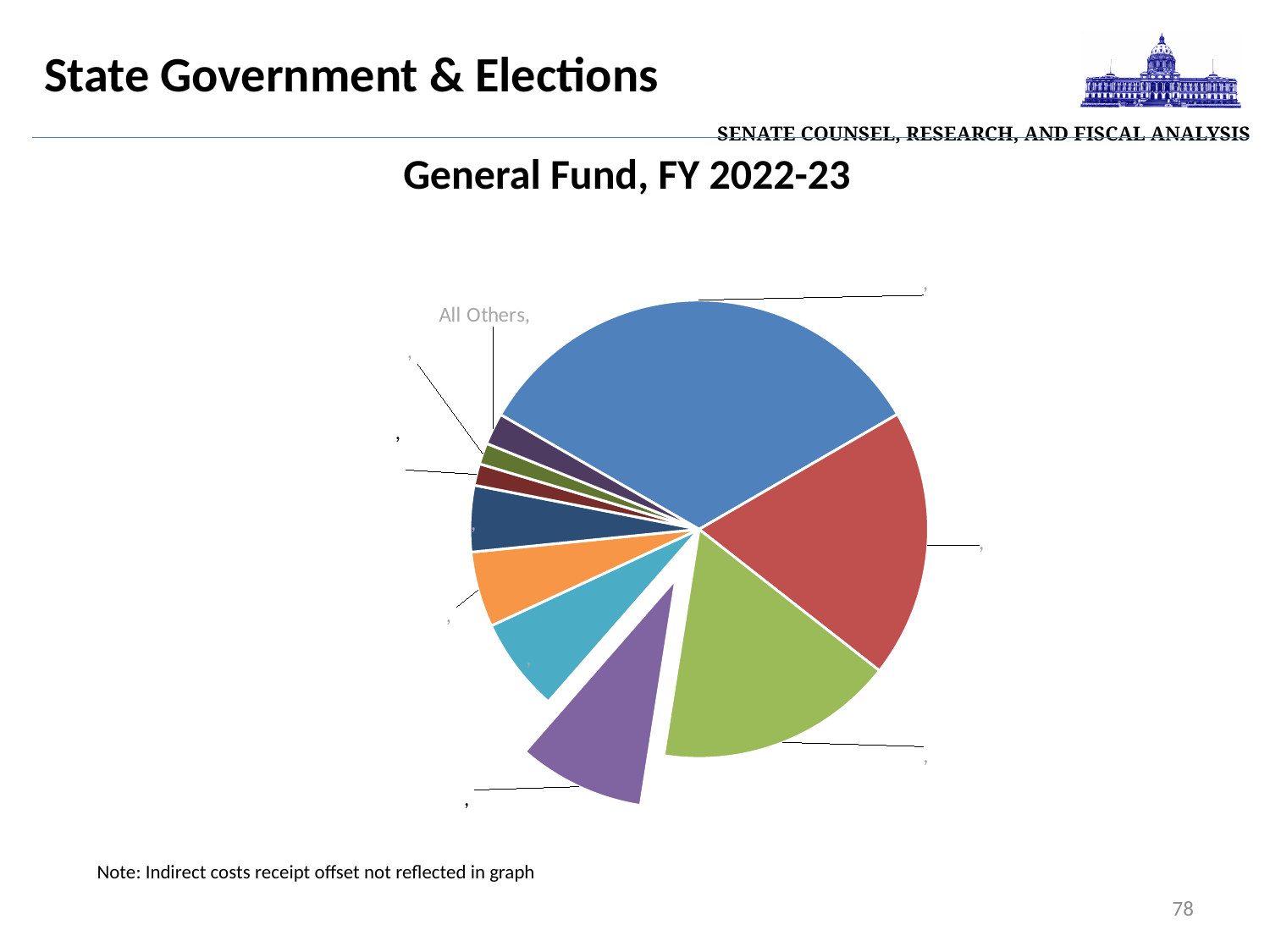
What kind of chart is shown on the slide? pie chart Which slice is pulled out (exploded) from the rest of the pie? the purple slice Which slice of the pie chart is the largest? the blue slice How many slices does the pie chart have? 10 What is the title of the pie chart? General Fund, FY 2022-23 Which is larger, the blue slice or the All Others slice? the blue slice